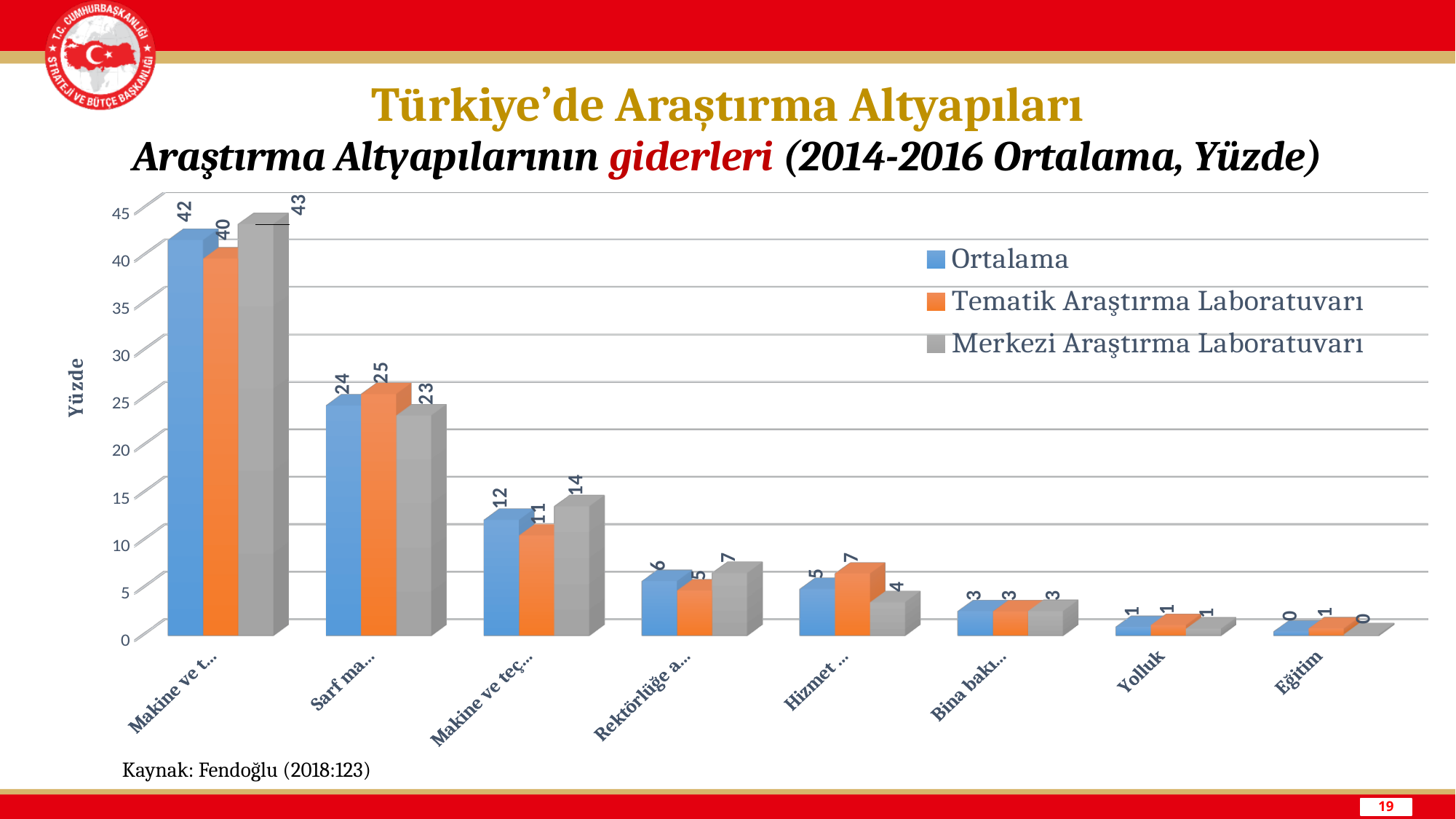
How many categories are shown along the x axis? 8 What is the Ortalama value for Yolluk? 1 In the leftmost category, what is the difference between the Merkezi Araştırma Laboratuvarı value and the Tematik Araştırma Laboratuvarı value? 3 How many series does the legend list? 3 What is the highest value shown anywhere on the chart? 43 In the fifth category from the left, which is larger: the Tematik Araştırma Laboratuvarı value or the Merkezi Araştırma Laboratuvarı value? Tematik Araştırma Laboratuvarı What is the title of the vertical axis? Yüzde Which series has the highest value in the leftmost category? Merkezi Araştırma Laboratuvarı What kind of chart is shown on the slide? bar chart Do the Ortalama values generally rise or fall from left to right along the x axis? fall What is the Merkezi Araştırma Laboratuvarı value for Eğitim? 0 What is the Tematik Araştırma Laboratuvarı value for Eğitim? 1